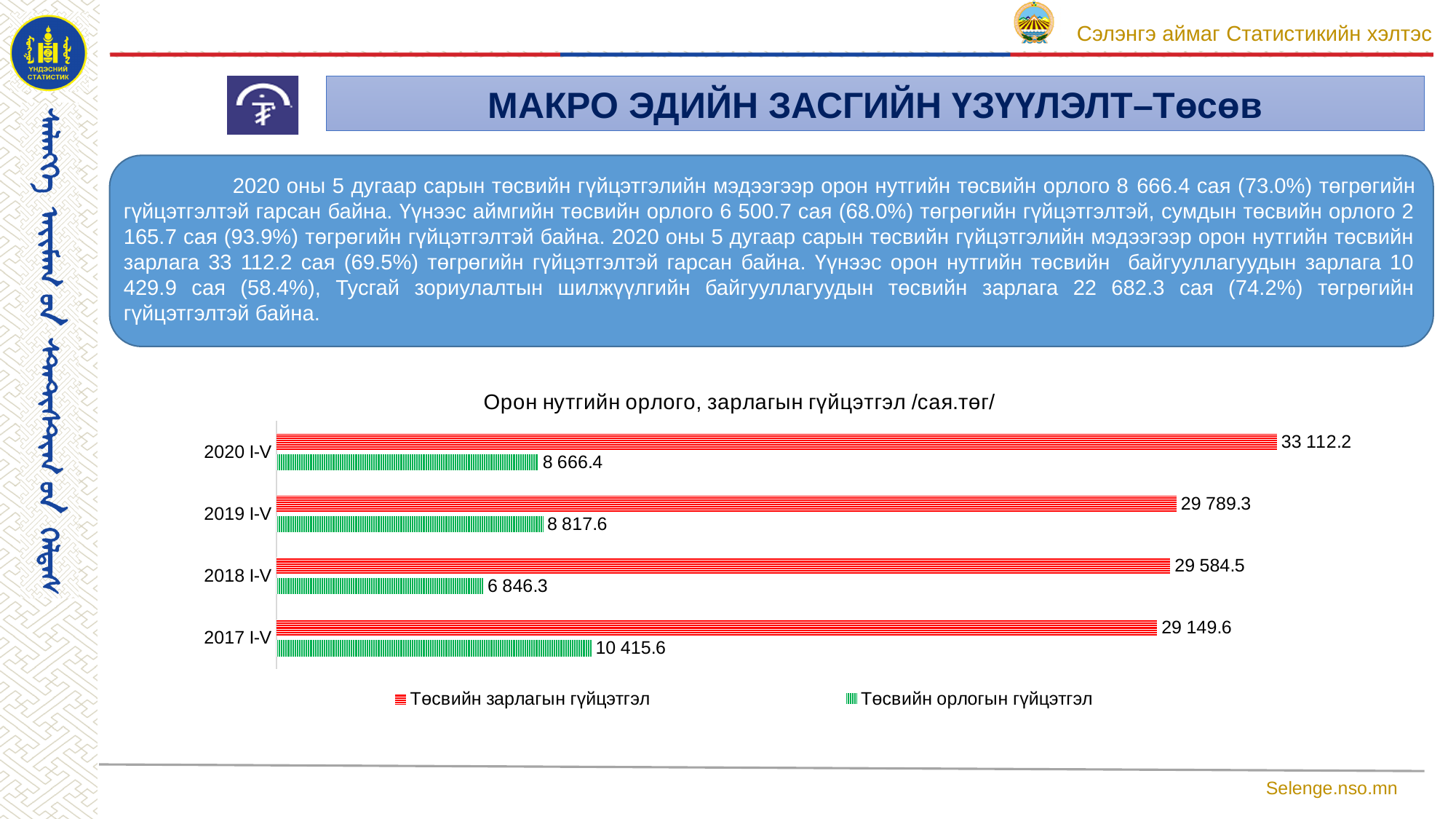
Which period has the lowest Төсвийн орлогын гүйцэтгэл? 2018 I-V What is the title of the chart? Орон нутгийн орлого, зарлагын гүйцэтгэл /сая.төг/ How many series does the chart legend list? 2 Which period has the highest Төсвийн зарлагын гүйцэтгэл? 2020 I-V What is the value of Төсвийн орлогын гүйцэтгэл for 2018 I-V? 6 846.3 What type of chart is shown on the slide? bar chart How many periods (categories) are shown on the chart? 4 Does Төсвийн зарлагын гүйцэтгэл rise or fall from 2017 I-V to 2020 I-V? rise What is the difference between Төсвийн зарлагын гүйцэтгэл and Төсвийн орлогын гүйцэтгэл for 2020 I-V? 24 445.8 Which is larger: Төсвийн орлогын гүйцэтгэл for 2017 I-V or for 2019 I-V? 2017 I-V What is the value of Төсвийн зарлагын гүйцэтгэл for 2020 I-V? 33 112.2 What is the value of Төсвийн орлогын гүйцэтгэл for 2017 I-V? 10 415.6